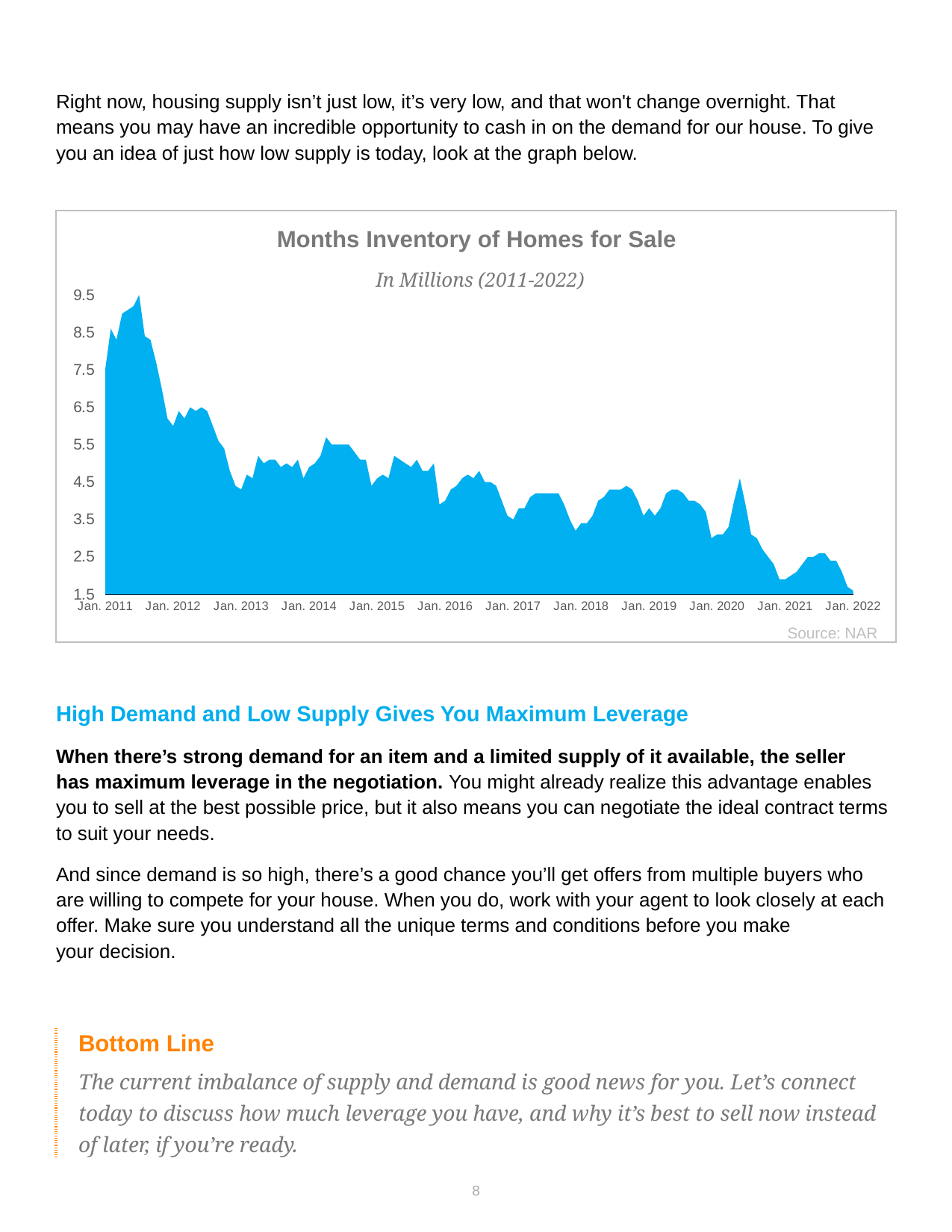
What source is cited for the chart? NAR What is the title of the chart? Months Inventory of Homes for Sale Is the value at Jan. 2020 greater or less than 4.5? less Is the value at Jan. 2021 greater or less than 2.5? less What kind of chart is shown on the slide? Area chart Which is larger, the value at Jan. 2011 or the value at Jan. 2022? Jan. 2011 How many year labels are shown on the x axis? 12 In which year does the chart reach its highest value? 2011 Overall, do the values rise or fall from Jan. 2011 to Jan. 2022? Fall Is the value at Jan. 2017 greater or less than 4.5? less